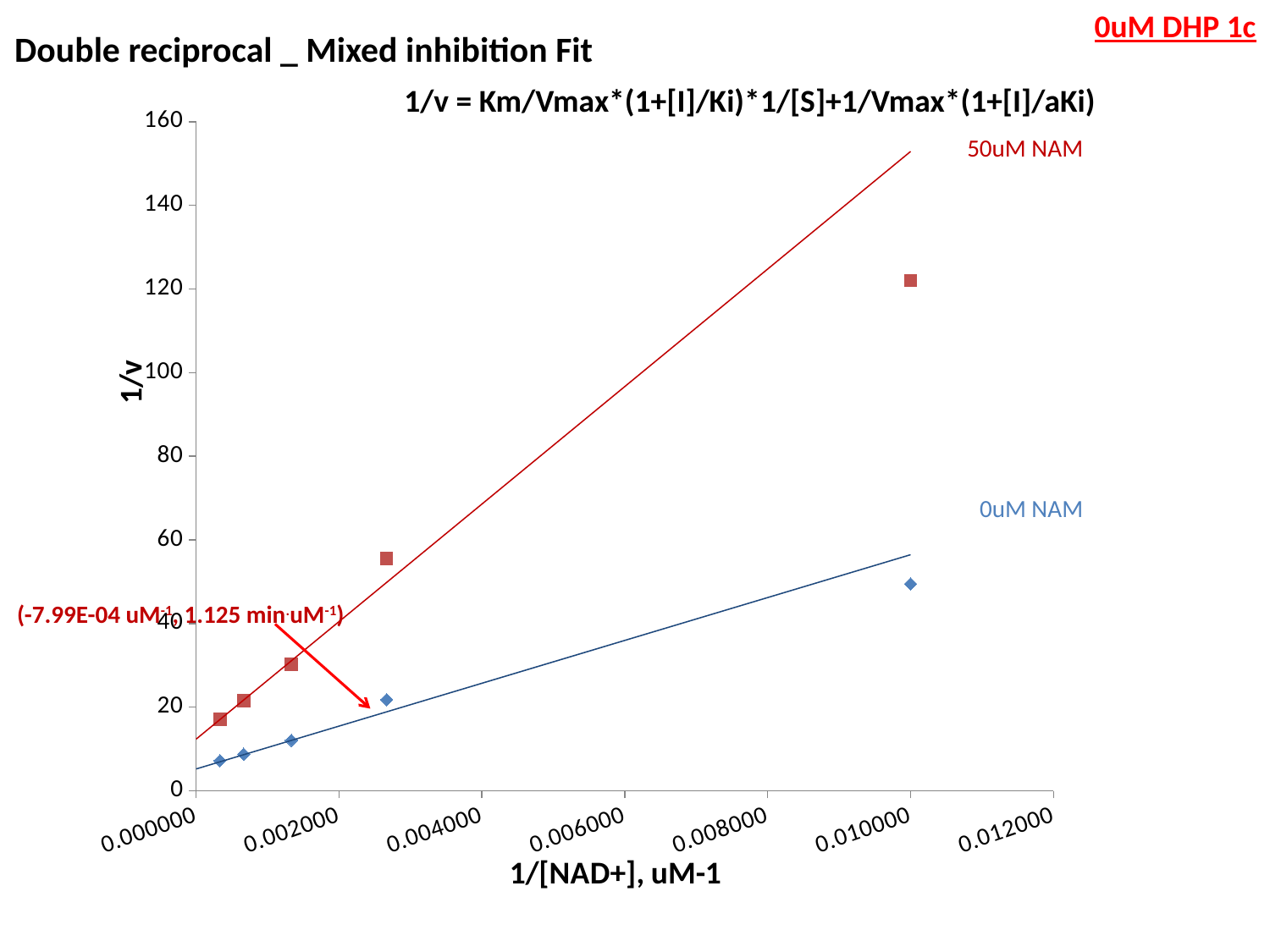
Which series has the steeper fitted line, 50uM NAM or 0uM NAM? 50uM NAM At the rightmost x position (near 0.010000), which series has the higher 1/v value, 50uM NAM or 0uM NAM? 50uM NAM Is the 1/v value of the 50uM NAM point near 0.002700 greater or less than 40? greater Is the 1/v value of the rightmost 0uM NAM point (near 0.010000) greater or less than 60? less How many data series are plotted on the chart? 4 What kind of chart is shown on the slide? Scatter chart What is the title of the chart? Double reciprocal _ Mixed inhibition Fit Is the 1/v value of the rightmost 50uM NAM point (near 0.010000) greater or less than 100? greater What is the label of the x axis? 1/[NAD+], uM-1 How many data points are plotted for the 50uM NAM series? 5 Do the 1/v values rise or fall as 1/[NAD+] increases along the x axis? rise How many data points are plotted for the 0uM NAM series? 5